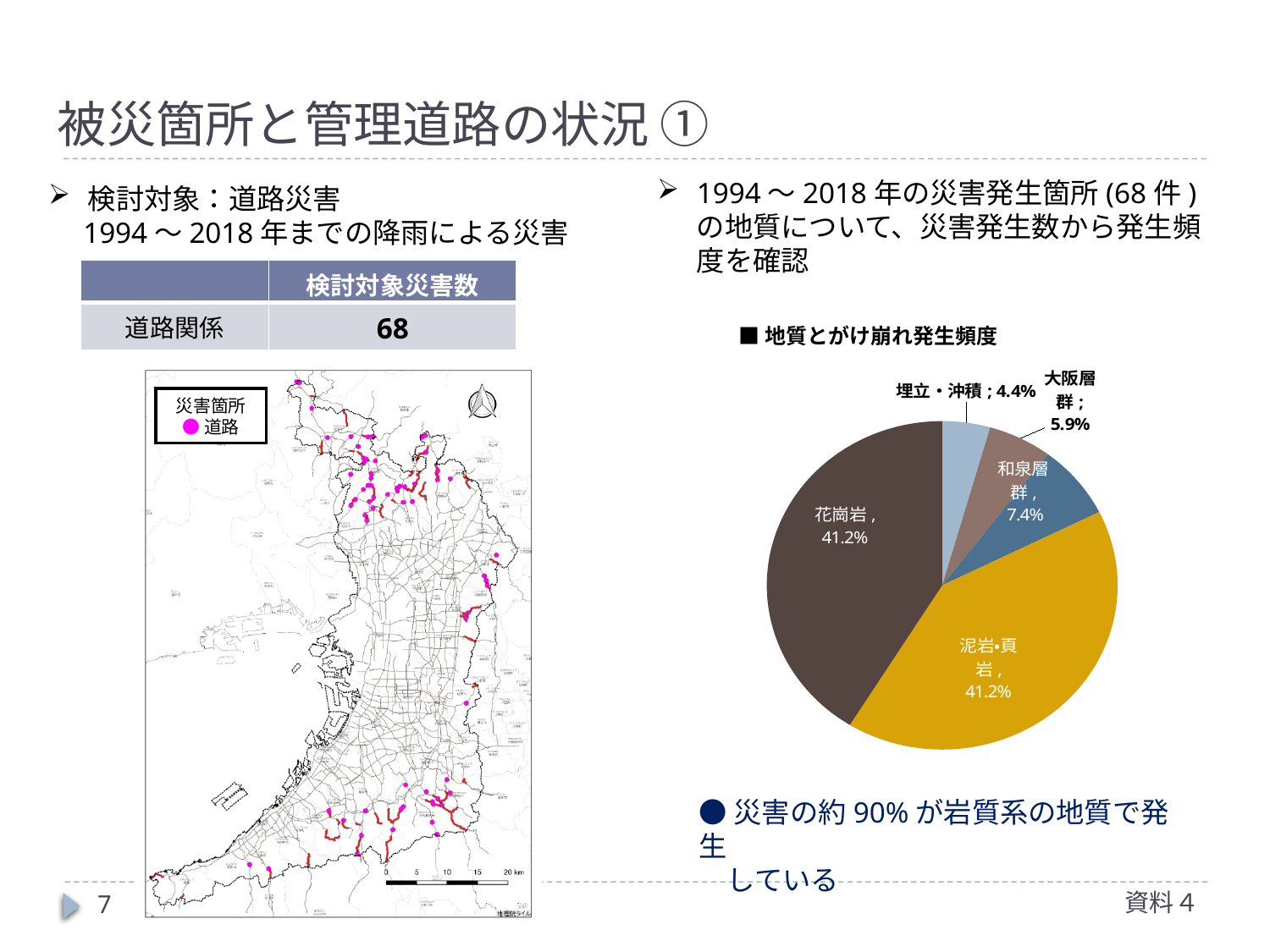
What kind of chart is shown under the heading 地質とがけ崩れ発生頻度? pie chart In the pie chart 地質とがけ崩れ発生頻度, what percentage is shown for 花崗岩? 41.2% What is the title of the pie chart on the right side of the slide? 地質とがけ崩れ発生頻度 In the pie chart 地質とがけ崩れ発生頻度, what is the combined share of 花崗岩 and 泥岩・頁岩? 82.4% In the pie chart 地質とがけ崩れ発生頻度, how many slices (geology categories) are there? 5 In the pie chart 地質とがけ崩れ発生頻度, what percentage is shown for 埋立・沖積? 4.4% In the pie chart 地質とがけ崩れ発生頻度, which is larger, the share for 和泉層群 or the share for 大阪層群? 和泉層群 In the pie chart 地質とがけ崩れ発生頻度, which geology category has the smallest share? 埋立・沖積 In the pie chart 地質とがけ崩れ発生頻度, what is the difference in percentage points between 和泉層群 and 大阪層群? 1.5 percentage points In the pie chart 地質とがけ崩れ発生頻度, what percentage is shown for 和泉層群? 7.4% In the pie chart 地質とがけ崩れ発生頻度, what percentage is shown for 大阪層群? 5.9% In the pie chart 地質とがけ崩れ発生頻度, what percentage is shown for 泥岩・頁岩? 41.2%